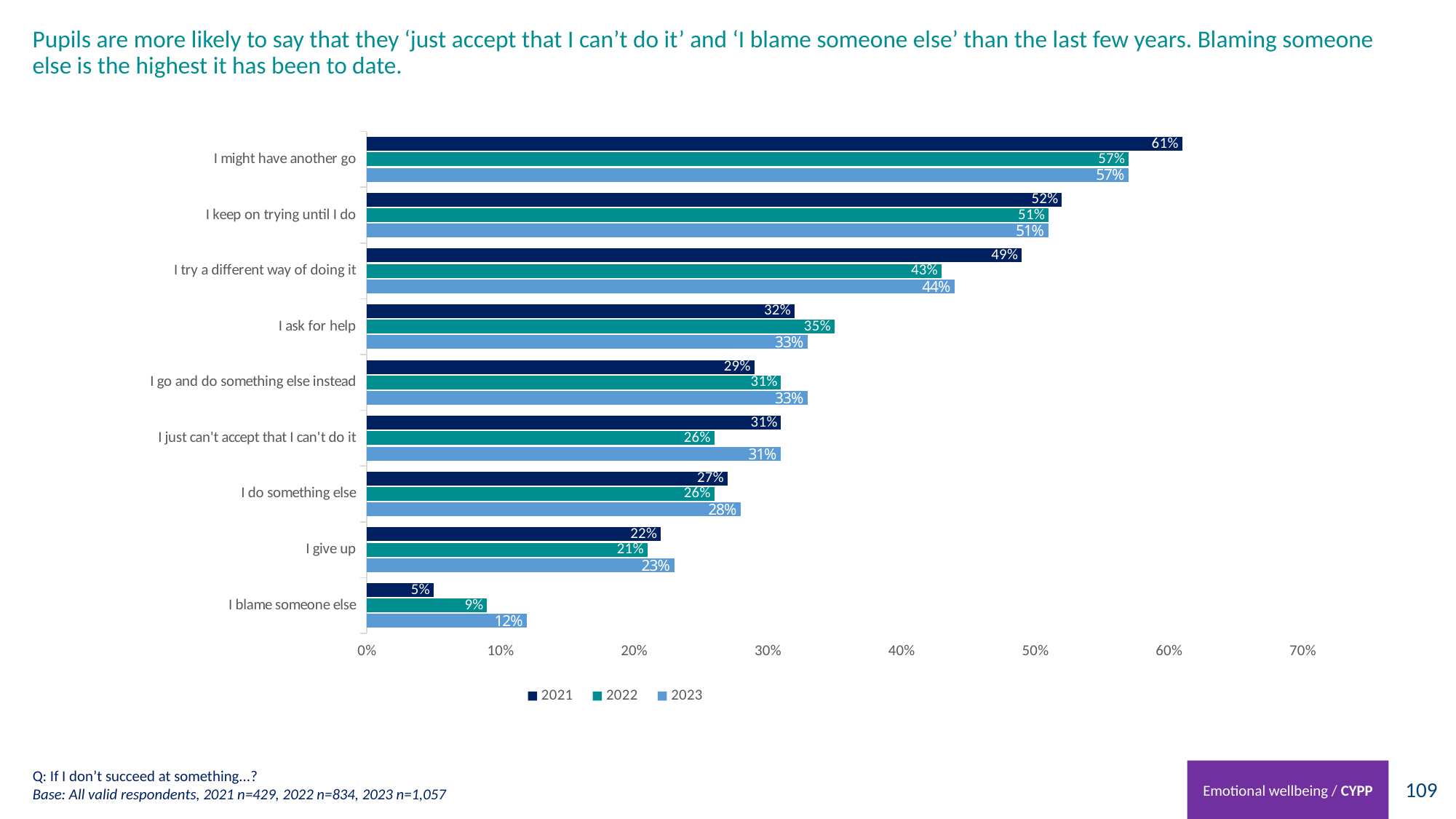
What is the difference between the 2021 and 2023 values for 'I try a different way of doing it'? 5% Which category has the highest 2023 value? I might have another go What is the 2021 value for 'I might have another go'? 61% What is the difference between the 2023 and 2021 values for 'I blame someone else'? 7% Which is larger for 'I just can't accept that I can't do it': the 2022 value or the 2023 value? 2023 What kind of chart is shown on the slide? Bar chart Which years are listed in the chart legend? 2021, 2022, 2023 What is the 2022 value for 'I ask for help'? 35% What is the 2023 value for 'I blame someone else'? 12% How many categories are shown on the chart? 9 How many series does the legend list? 3 Which category has the lowest 2021 value? I blame someone else